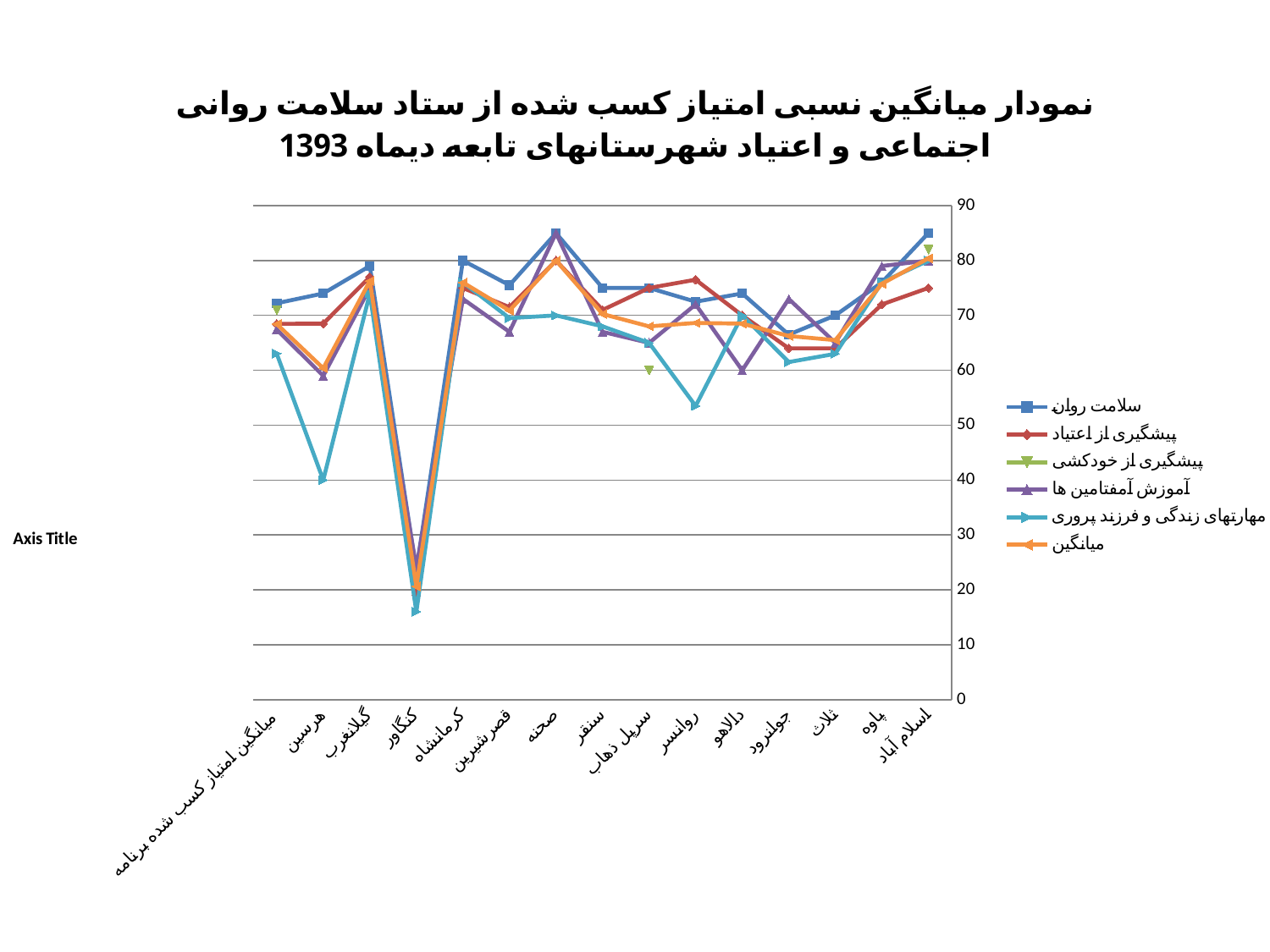
In the مهارتهای زندگی و فرزند پروری series, which is larger: the value for هرسین or the value for گیلانغرب? گیلانغرب How many categories are shown along the x axis? 15 Is the value for کنگاور in the مهارتهای زندگی و فرزند پروری series greater or less than 20? less In the سلامت روان series, which is larger: the value for کنگاور or the value for کرمانشاه? کرمانشاه How many series does the legend list? 6 Which category has the lowest value in the سلامت روان series? کنگاور Is the value for هرسین in the مهارتهای زندگی و فرزند پروری series greater or less than 50? less Is the value for اسلام آباد in the سلامت روان series greater or less than 80? greater What is the title shown on the vertical axis? Axis Title What kind of chart is shown on the slide? line chart